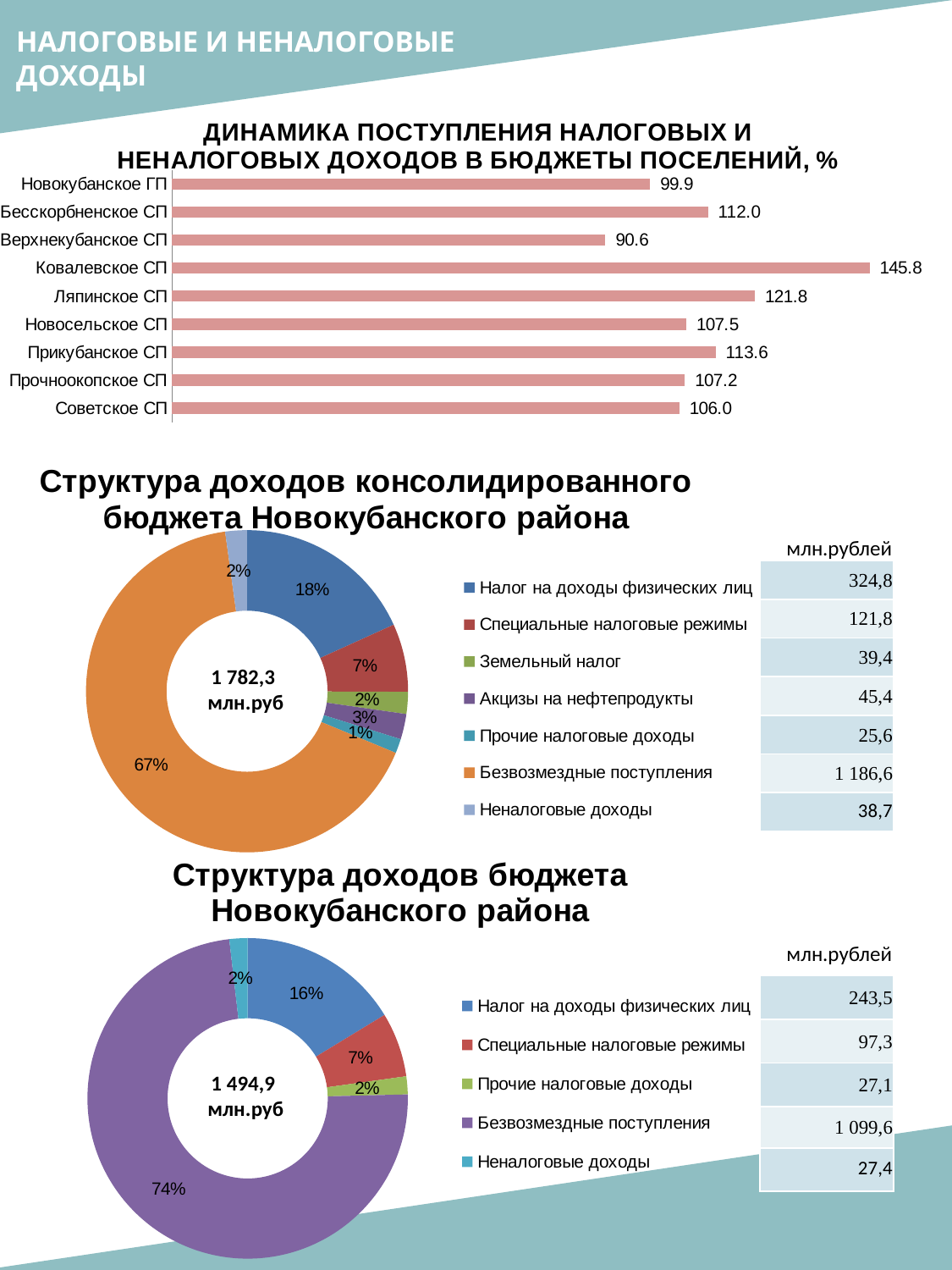
In the bar chart 'Динамика поступления налоговых и неналоговых доходов в бюджеты поселений, %', what is the value for Ковалевское СП? 145.8 How many entries does the legend of the donut chart 'Структура доходов консолидированного бюджета Новокубанского района' list? 7 In the bar chart at the top of the slide, what is the difference between the values for Ковалевское СП and Верхнекубанское СП? 55.2 How many settlements are shown in the bar chart at the top of the slide? 9 What kind of chart is the top chart on the slide? Bar chart What total is shown in the centre of the donut chart 'Структура доходов бюджета Новокубанского района'? 1 494,9 млн.руб In the bar chart at the top of the slide, which is larger: the value for Бесскорбненское СП or for Прикубанское СП? Прикубанское СП In the bar chart at the top of the slide, which settlement has the lowest value? Верхнекубанское СП In the table next to the donut chart 'Структура доходов бюджета Новокубанского района', what is the value for Безвозмездные поступления? 1 099,6 In the donut chart 'Структура доходов консолидированного бюджета Новокубанского района', what share is Безвозмездные поступления? 67% In the bar chart at the top of the slide, which settlement has the highest value? Ковалевское СП In the donut chart 'Структура доходов бюджета Новокубанского района', what share is Налог на доходы физических лиц? 16%